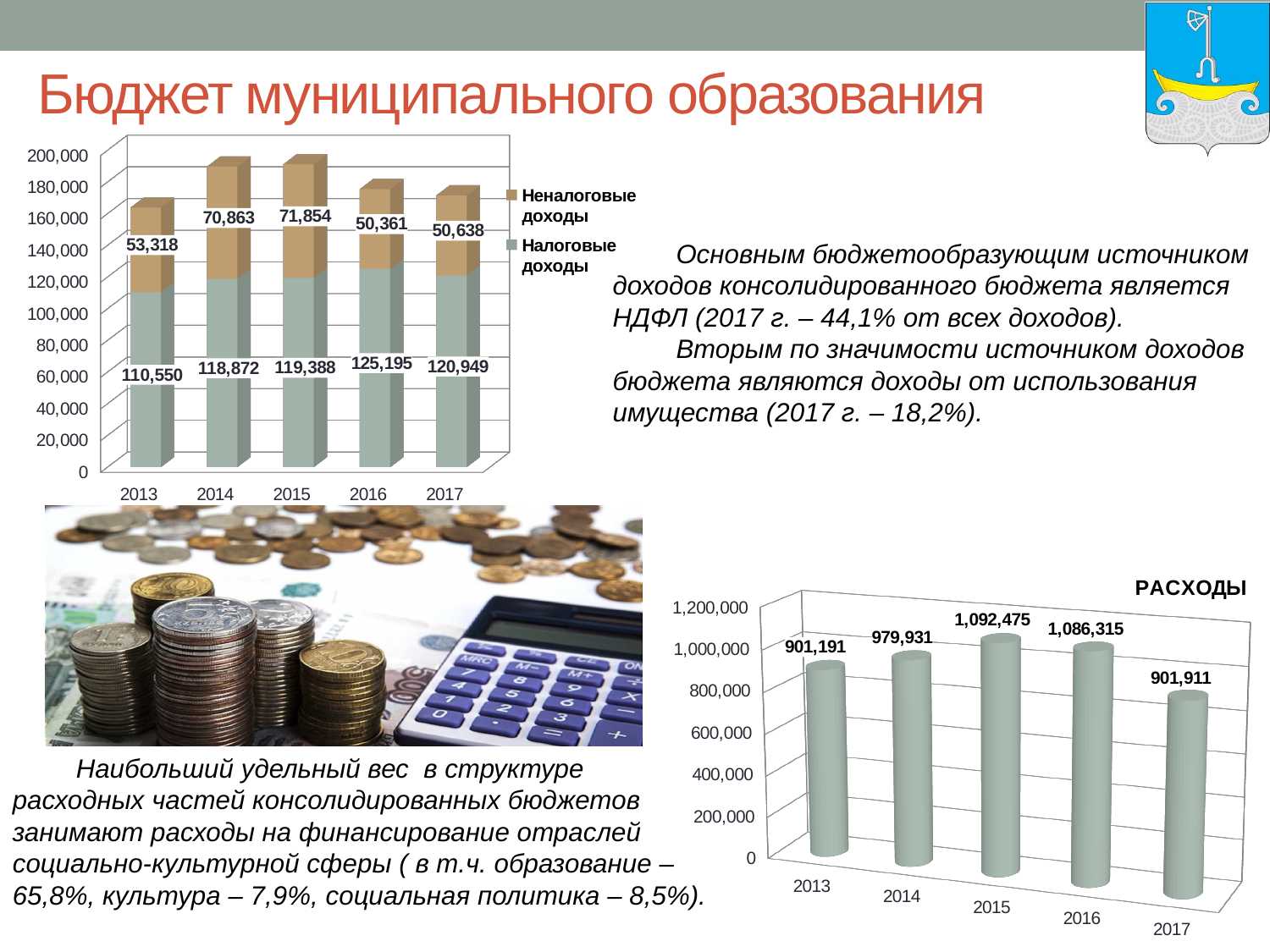
How many series does the legend of the top-left stacked bar chart list? 2 In the top-left stacked bar chart, which year has the lowest Налоговые доходы? 2013 In the top-left stacked bar chart, what is the value of Неналоговые доходы for 2014? 70,863 In the РАСХОДЫ chart, which year has the lowest value? 2013 In the РАСХОДЫ chart, what is the value for 2015? 1,092,475 In the top-left stacked bar chart, what is the difference between Налоговые доходы in 2016 and 2013? 14,645 In the top-left stacked bar chart, what is the value of Налоговые доходы for 2016? 125,195 In the РАСХОДЫ chart, what is the difference between the values for 2015 and 2017? 190,564 What kind of chart is the РАСХОДЫ chart? Bar chart In the top-left stacked bar chart, which series is shown in brown? Неналоговые доходы In the top-left stacked bar chart, which year has the highest Неналоговые доходы? 2015 In the top-left stacked bar chart, what is the total of the stacked bar for 2013? 163,868